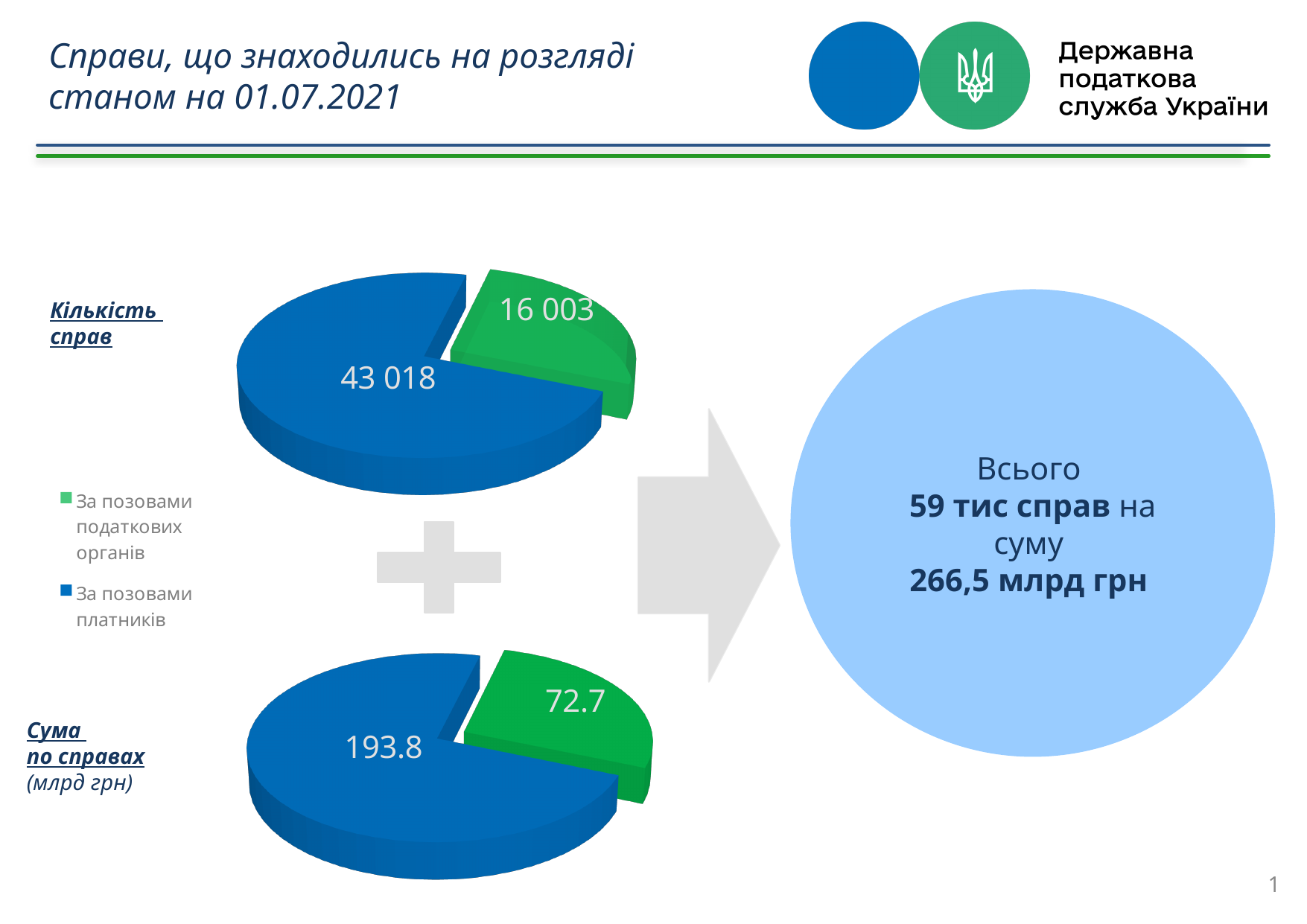
In the 'Кількість справ' pie chart, what is the value for 'За позовами платників'? 43 018 In the 'Кількість справ' pie chart, what is the difference between the values for 'За позовами платників' and 'За позовами податкових органів'? 27 015 In the 'Кількість справ' pie chart, which category has the largest slice? За позовами платників In the 'Сума по справах (млрд грн)' pie chart, what is the value for 'За позовами податкових органів'? 72.7 In the 'Сума по справах (млрд грн)' pie chart, which category has the smallest slice? За позовами податкових органів In the pie charts, which colour represents 'За позовами податкових органів'? Green In the 'Кількість справ' pie chart, what is the value for 'За позовами податкових органів'? 16 003 What type of chart is used for 'Сума по справах (млрд грн)'? Pie chart How many slices does the 'Кількість справ' pie chart have? 2 In the 'Сума по справах (млрд грн)' pie chart, which is larger: 'За позовами платників' or 'За позовами податкових органів'? За позовами платників In the 'Сума по справах (млрд грн)' pie chart, what is the difference between the values for 'За позовами платників' and 'За позовами податкових органів'? 121.1 In the 'Сума по справах (млрд грн)' pie chart, what is the value for 'За позовами платників'? 193.8